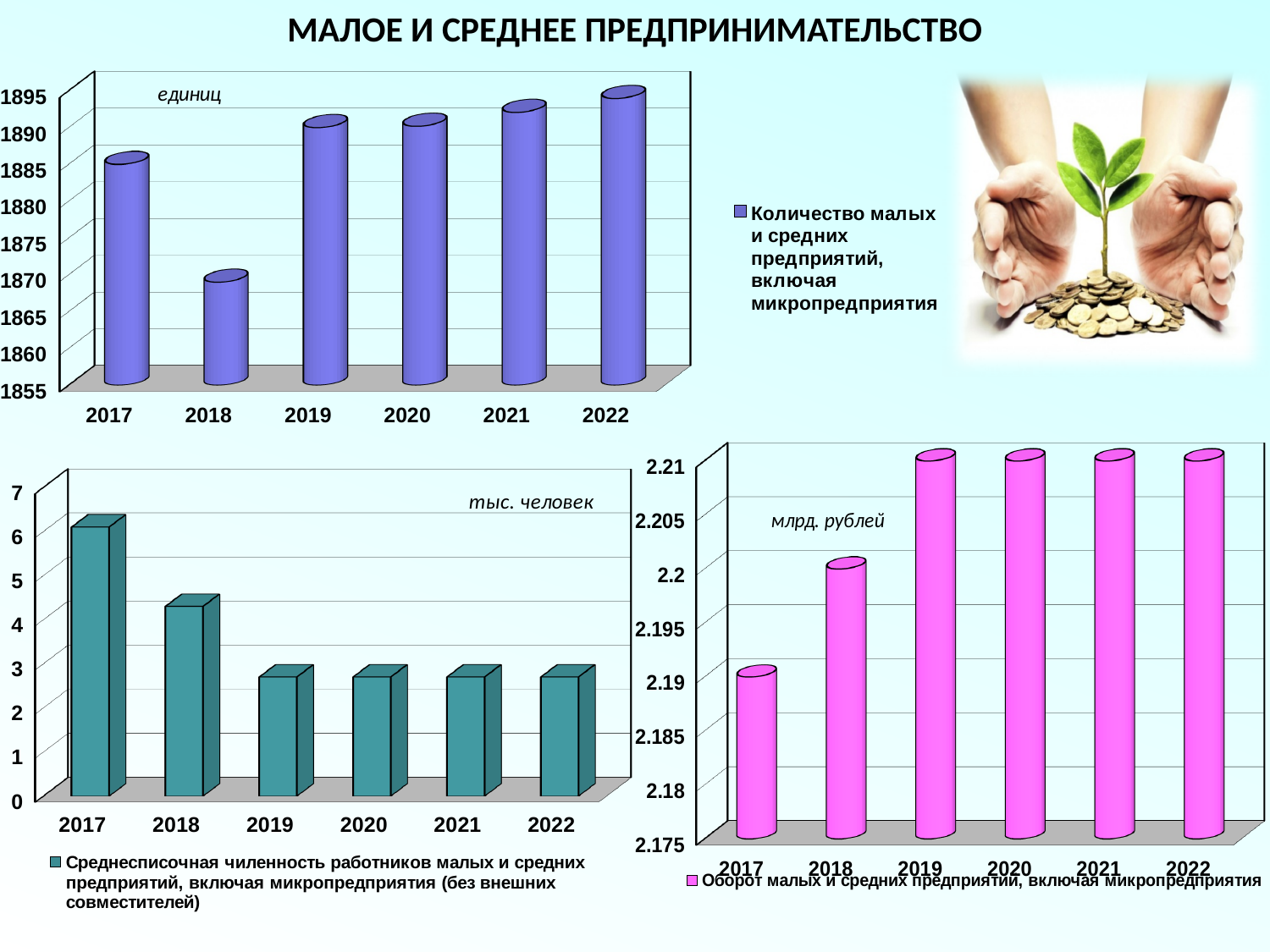
In the bottom-left chart (тыс. человек), which year has the highest value? 2017 What is the title of the slide? МАЛОЕ И СРЕДНЕЕ ПРЕДПРИНИМАТЕЛЬСТВО In the top-left chart (единиц), which year has the highest value? 2022 In the top-left chart (единиц), is the value for 2017 greater or less than 1880? greater In the top-left chart (единиц), is the value for 2018 greater or less than 1875? less What kind of chart is the top-left chart (единиц)? bar chart In the top-left chart (единиц), how many years are shown on the x axis? 6 In the bottom-left chart (тыс. человек), which is larger, the value for 2017 or the value for 2019? 2017 In the bottom-right chart (млрд. рублей), which year has the lowest value? 2017 In the bottom-right chart (млрд. рублей), is the value for 2019 greater or less than 2.205? greater In the top-left chart (единиц), which year has the lowest value? 2018